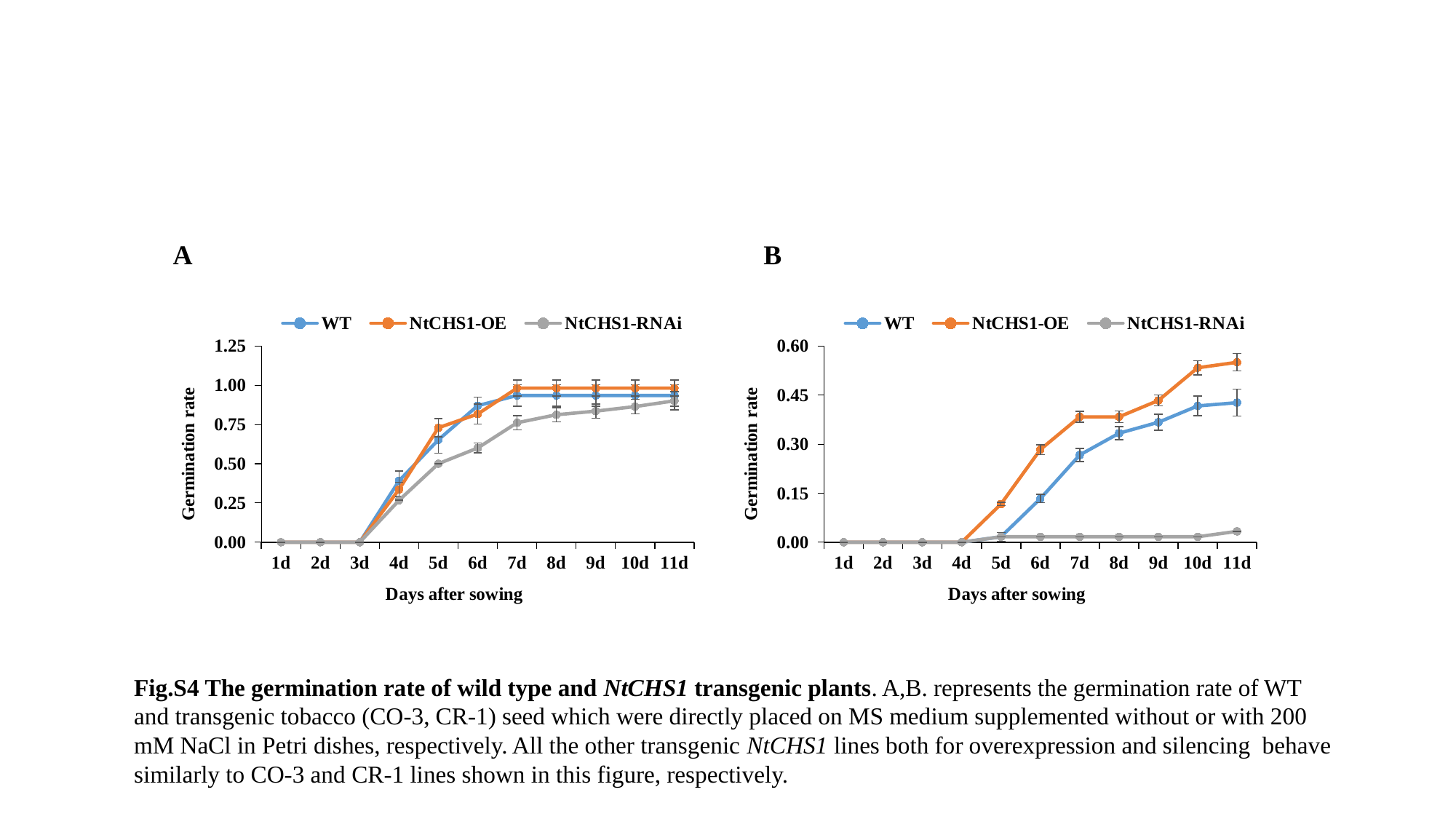
In chart B, what is the germination rate of NtCHS1-OE at 4d? 0.00 In chart A, is the value for WT at 4d greater or less than 0.50? less How many time points are shown on the x axis of chart A? 11 In chart B, which series has the highest germination rate at 11d? NtCHS1-OE In chart A, what is the germination rate of WT at 1d? 0.00 In chart A, which series has the lowest germination rate at 11d? NtCHS1-RNAi In chart B, is the value for NtCHS1-OE at 11d greater or less than 0.45? greater In chart B, does the germination rate of NtCHS1-OE rise or fall from 4d to 11d? rise How many series does the legend of chart B list? 3 In chart A, is the value for NtCHS1-RNAi at 6d greater or less than 0.50? greater What kind of chart is chart A? line chart